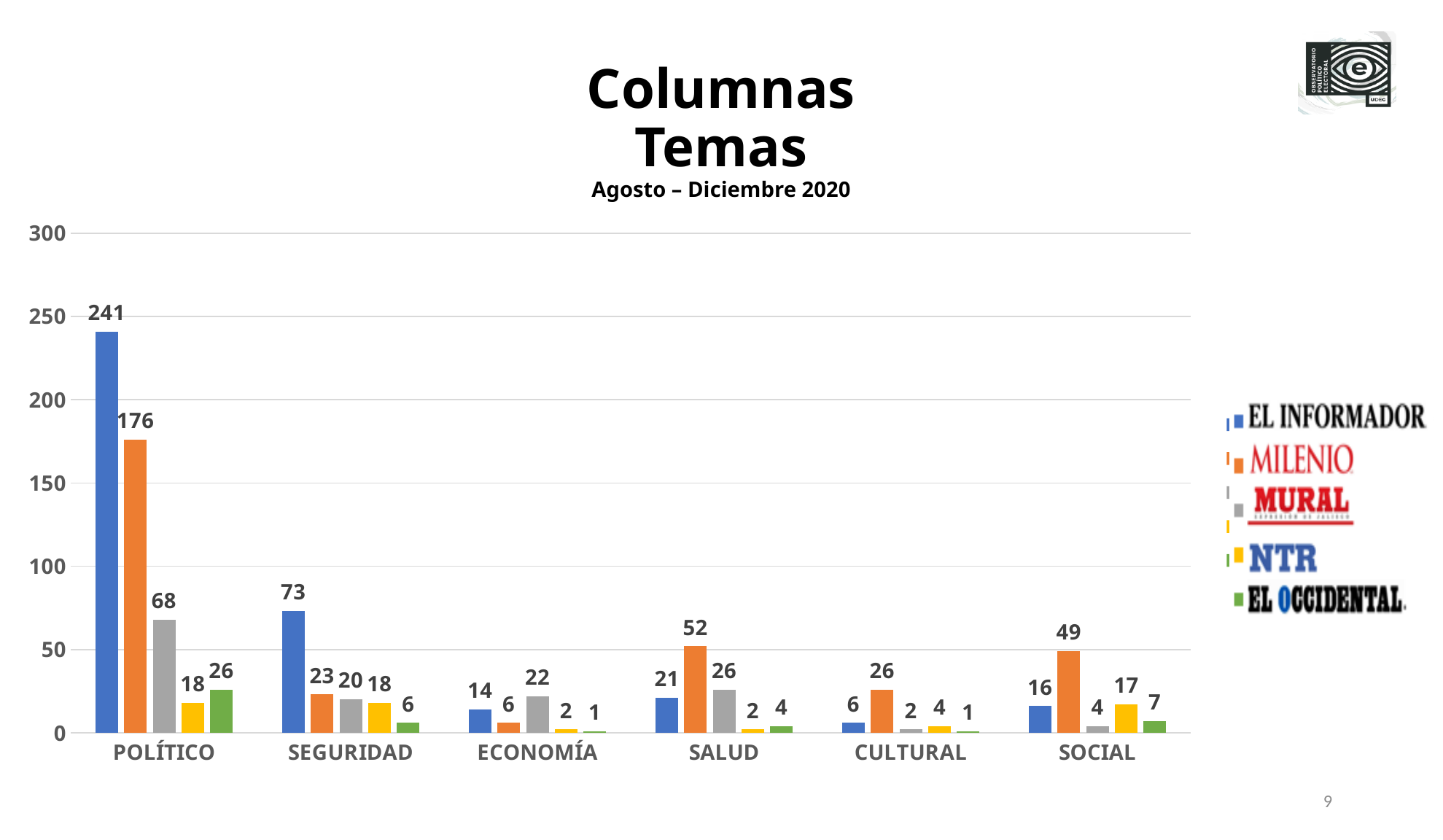
Is the value for El Informador in the SEGURIDAD category greater or less than 50? greater Which category has the highest value for El Informador? POLÍTICO What is the value for NTR in the SOCIAL category? 17 How many categories are shown on the x axis? 6 What kind of chart is shown on the slide? Bar chart What is the value for Milenio in the SALUD category? 52 What is the value for Mural in the ECONOMÍA category? 22 In the SOCIAL category, which is larger: Milenio or El Informador? Milenio What is the difference between El Informador and Milenio in the POLÍTICO category? 65 What is the value for El Informador in the POLÍTICO category? 241 How many series does the legend list? 5